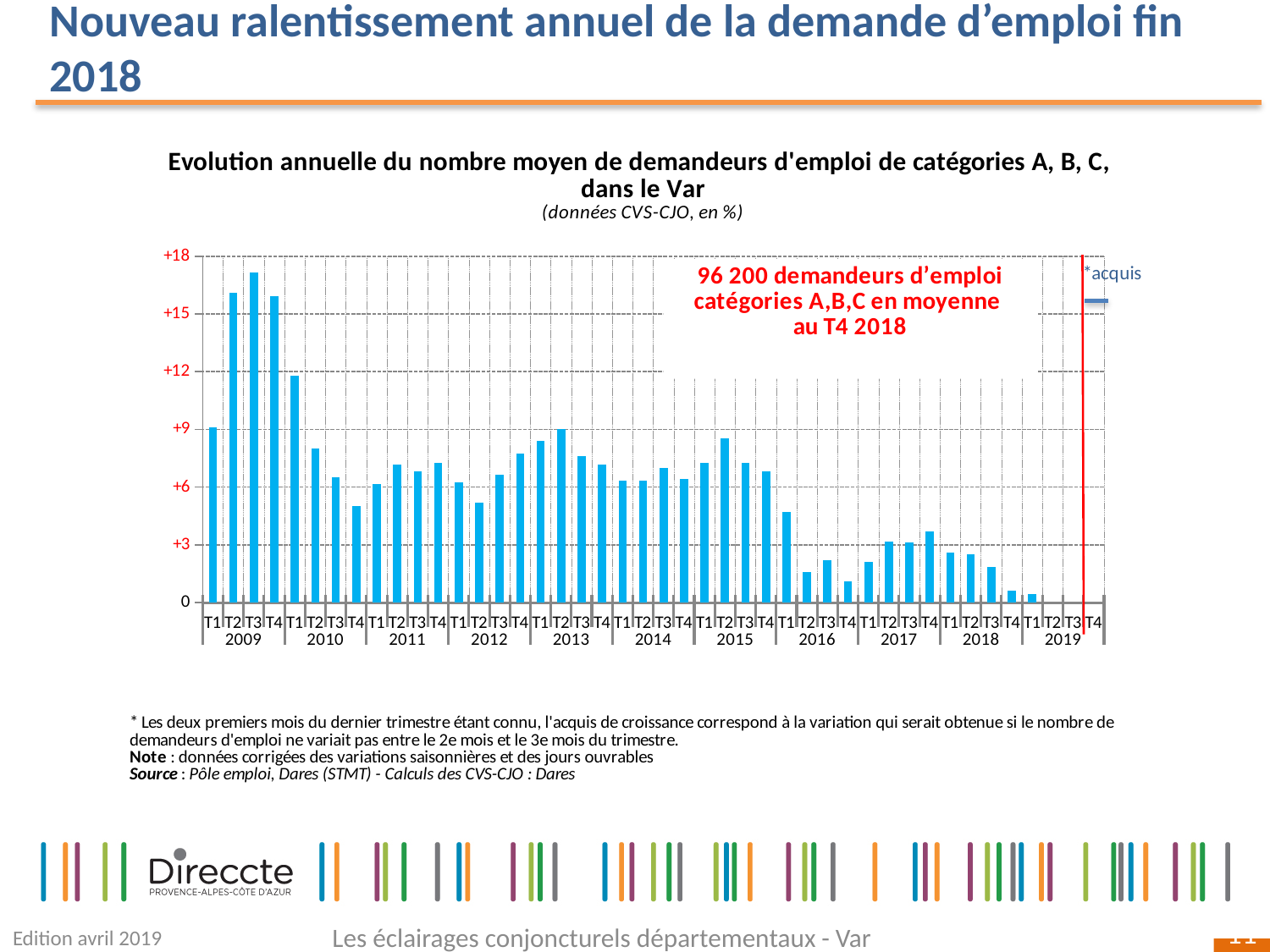
Which quarter has the highest bar in the chart? T3 2009 Which is larger, the value for T3 2009 or the value for T1 2010? T3 2009 Do the values generally rise or fall from 2015 to 2018? fall According to the annotation on the chart, how many job seekers in categories A, B, C were there on average in T4 2018? 96 200 Is the value for T4 2010 greater or less than 6? less Is the value for T4 2016 greater or less than 3? less What kind of chart is shown on the slide? bar chart Is the value for T1 2019 greater or less than 3? less How many years are labelled on the x axis of the chart? 11 Which is larger, the value for T2 2015 or the value for T1 2016? T2 2015